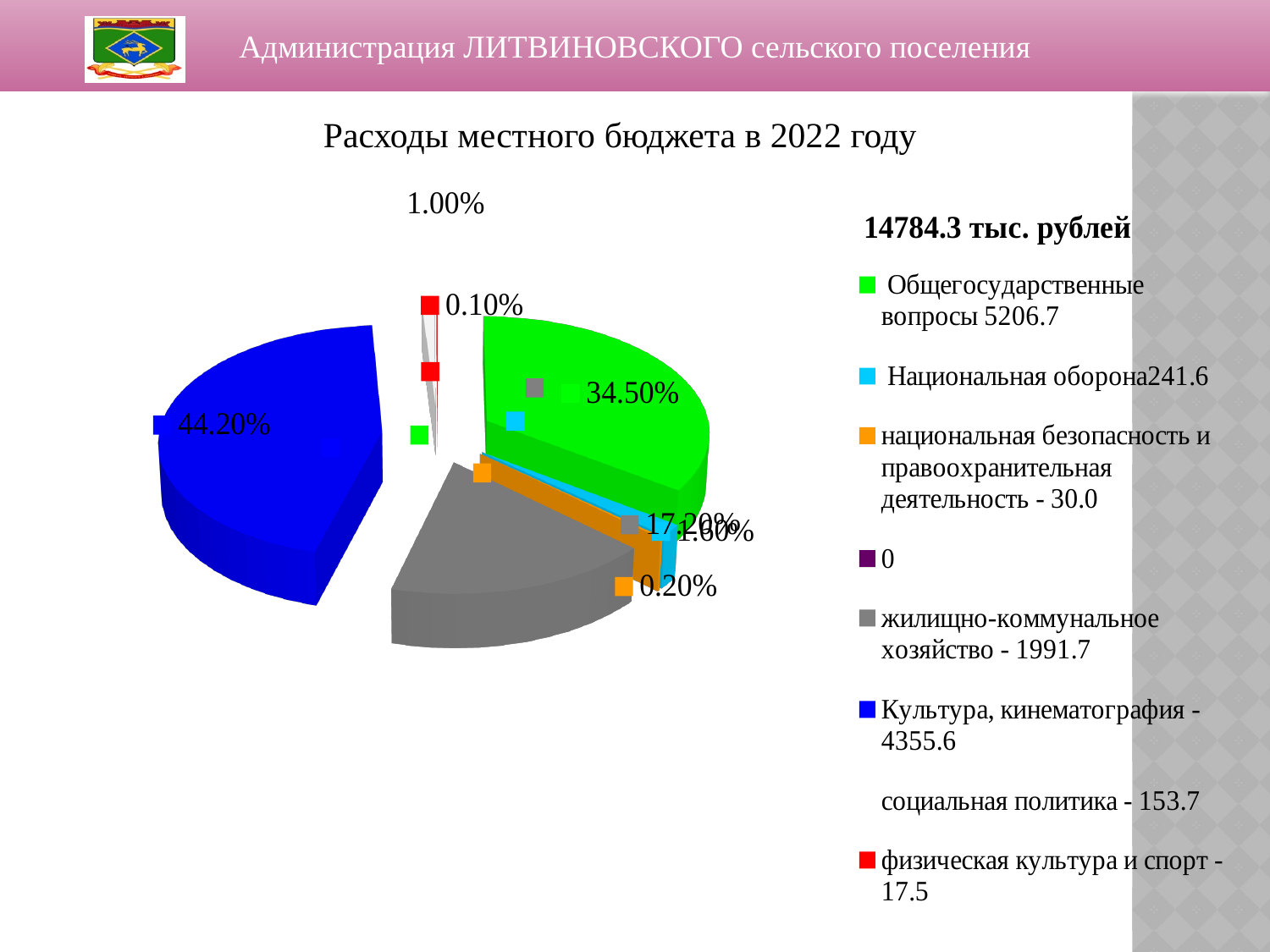
What is the title of the chart? Расходы местного бюджета в 2022 году What is the difference in percentage points between the blue slice (44.20%) and the green slice (34.50%)? 9.70% What percentage share is labelled on the blue slice (Культура, кинематография)? 44.20% What percentage share is labelled on the green slice (Общегосударственные вопросы)? 34.50% What is the smallest percentage labelled on the pie chart? 0.10% What amount does the legend give for Общегосударственные вопросы? 5206.7 Which is larger: the amount for Общегосударственные вопросы or for Культура, кинематография? Общегосударственные вопросы Which category has the largest slice of the pie? Культура, кинематография What kind of chart is shown on the slide? pie chart What amount does the legend give for жилищно-коммунальное хозяйство? 1991.7 What percentage share is labelled on the gray slice (жилищно-коммунальное хозяйство)? 17.20% What total amount in тыс. рублей is shown above the legend? 14784.3 тыс. рублей